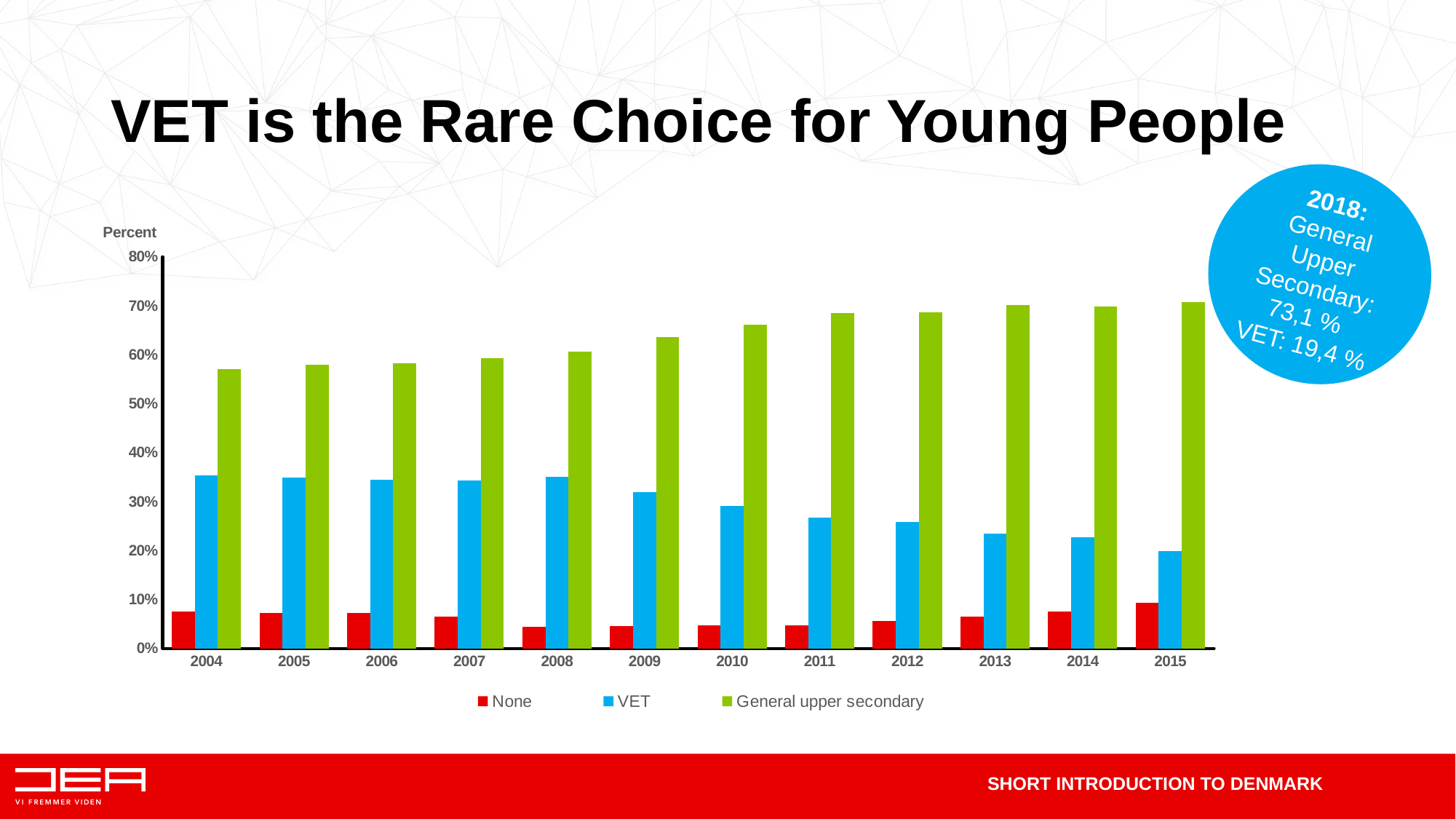
Is the value for General upper secondary in 2010 greater or less than 60%? greater Is the value for VET in 2004 greater or less than 30%? greater What label is shown on the vertical axis? Percent Is the value for General upper secondary in 2004 greater or less than 60%? less Does the General upper secondary series rise or fall from 2004 to 2015? rise How many years are shown on the x axis? 12 How many series does the legend list? 3 What kind of chart is shown on the slide? bar chart Which is larger in 2012, VET or General upper secondary? General upper secondary In which year is the VET value lowest? 2015 Does the VET series rise or fall from 2004 to 2015? fall